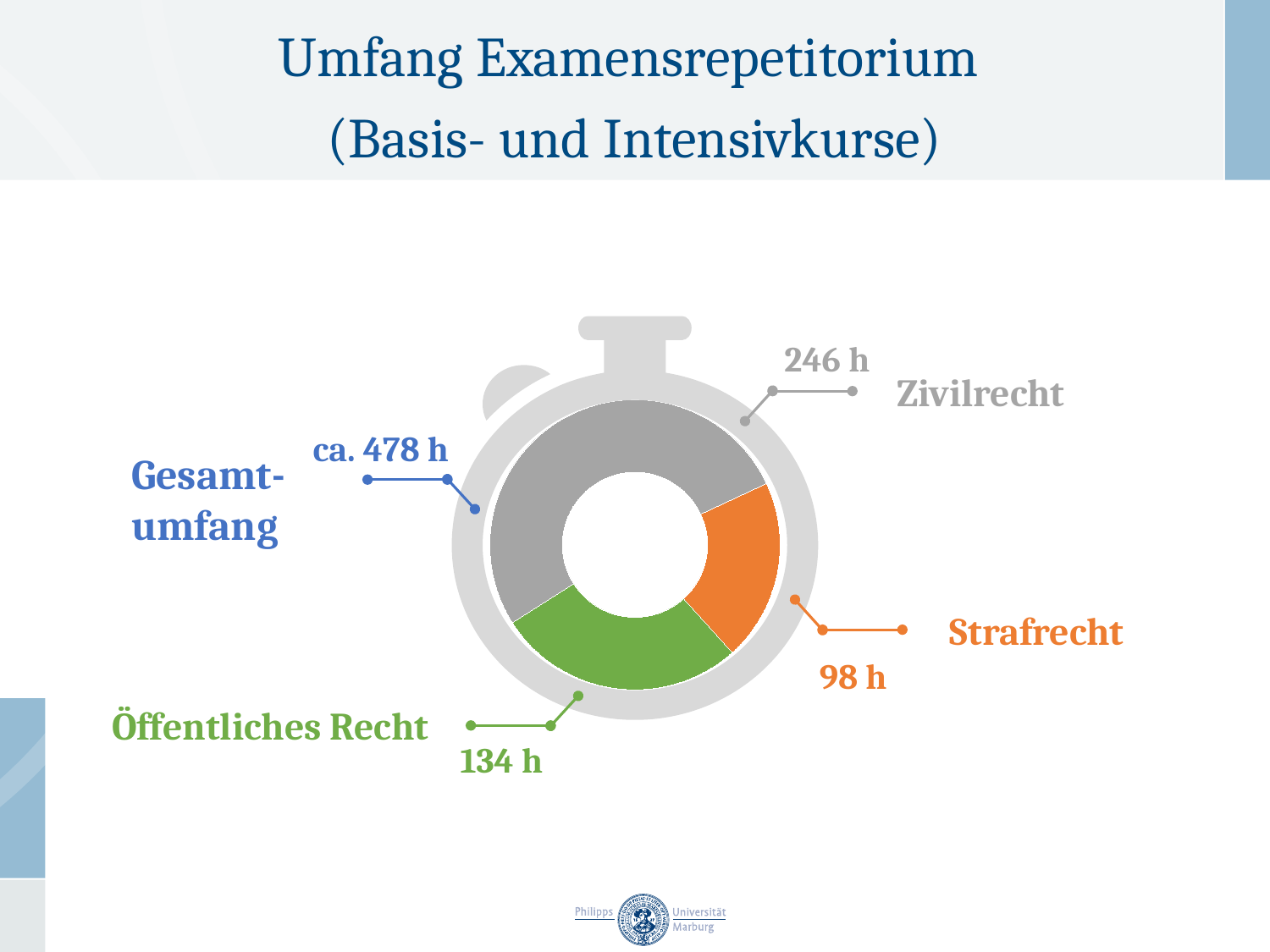
What is the Gesamtumfang (total) shown on the slide? ca. 478 h Which subject area has the smallest number of hours? Strafrecht How many hours are shown for Zivilrecht? 246 h How many hours are shown for Strafrecht? 98 h What kind of chart is shown on the slide? Pie chart (donut) What is the difference in hours between Zivilrecht and Strafrecht? 148 h What is the difference in hours between Öffentliches Recht and Strafrecht? 36 h How many hours are shown for Öffentliches Recht? 134 h Which has more hours, Öffentliches Recht or Strafrecht? Öffentliches Recht How many segments does the chart have? 3 Which subject area has the largest number of hours? Zivilrecht What colour is the Strafrecht segment? Orange